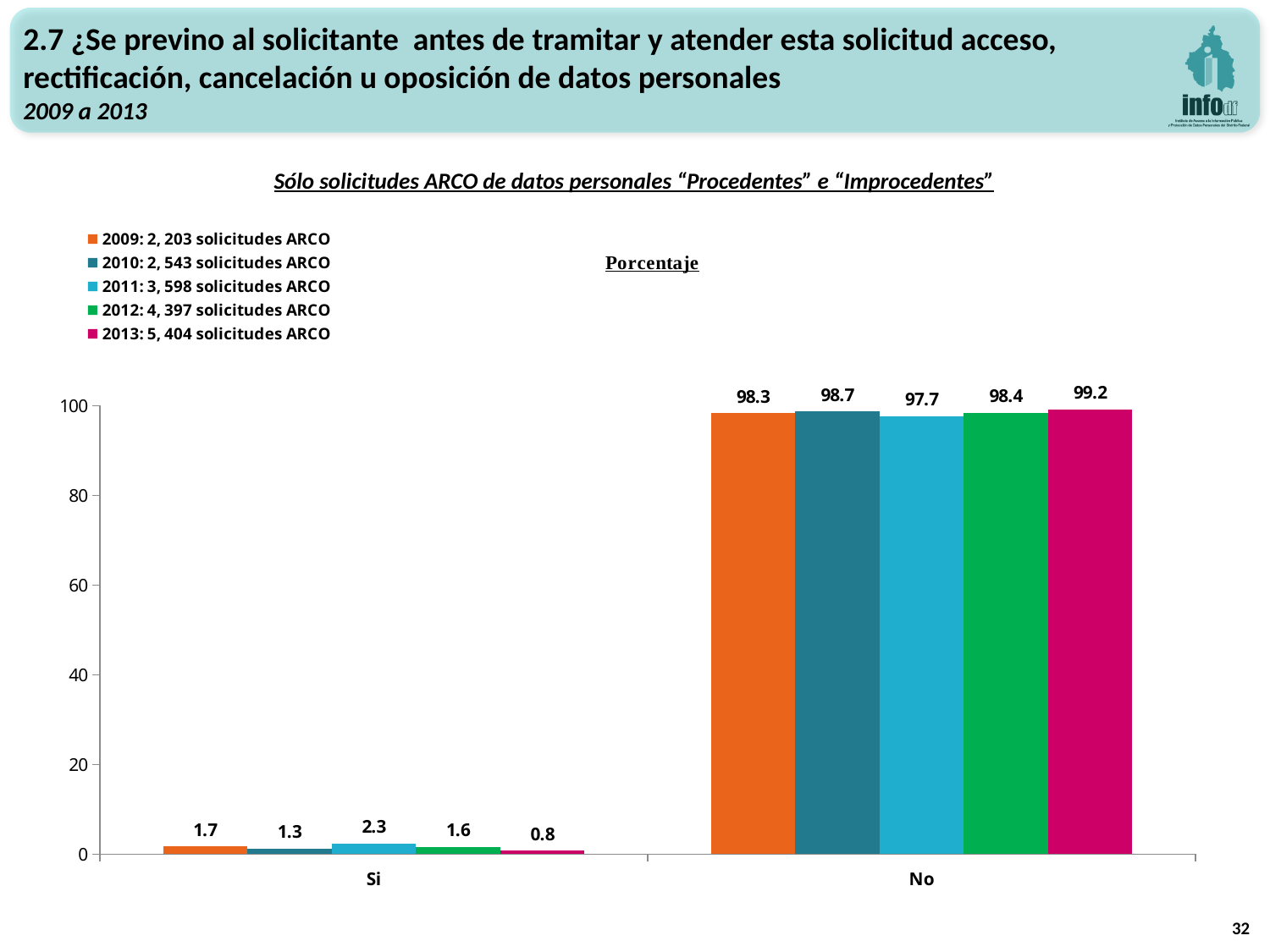
What is the value for 2011 in the "Si" category? 2.3 What is the value for 2013 in the "No" category? 99.2 How many categories are shown on the x axis? 2 What is the total of the 2012 values across the "Si" and "No" categories? 100 Which year has the lowest value in the "No" category? 2011 According to the legend, how many solicitudes ARCO were there in 2013? 5, 404 Which year has the highest value in the "Si" category? 2011 How many series does the legend list? 5 What is the difference between the 2013 and 2009 values in the "No" category? 0.9 Which is larger in the "Si" category: the value for 2010 or the value for 2012? 2012 What kind of chart is shown on the slide? Bar chart What is the value for 2009 in the "Si" category? 1.7